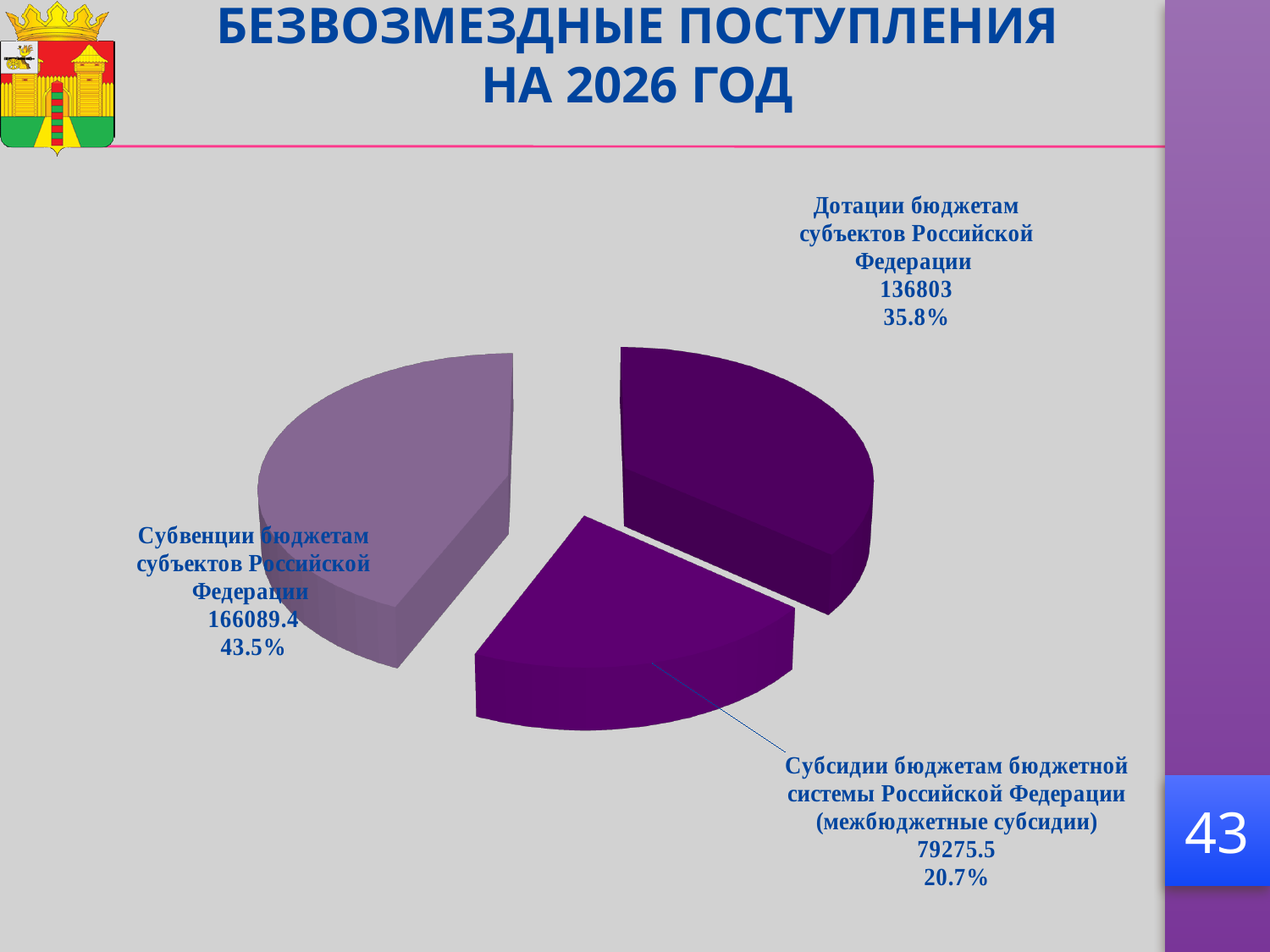
What is the value for Субвенции бюджетам субъектов Российской Федерации? 166089.4 What share of the pie does Субсидии бюджетам бюджетной системы Российской Федерации (межбюджетные субсидии) represent? 20.7% What is the value for Субсидии бюджетам бюджетной системы Российской Федерации (межбюджетные субсидии)? 79275.5 Which category has the smallest value? Субсидии бюджетам бюджетной системы Российской Федерации (межбюджетные субсидии) What share of the pie does Субвенции бюджетам субъектов Российской Федерации represent? 43.5% What is the difference between the values for Субвенции бюджетам субъектов Российской Федерации and Дотации бюджетам субъектов Российской Федерации? 29286.4 How many slices does the pie chart have? 3 Which is larger: the value for Дотации бюджетам субъектов Российской Федерации or the value for Субсидии бюджетам бюджетной системы Российской Федерации (межбюджетные субсидии)? Дотации бюджетам субъектов Российской Федерации What type of chart is shown on the slide? pie chart Which category has the largest value? Субвенции бюджетам субъектов Российской Федерации What is the title of the slide containing the pie chart? БЕЗВОЗМЕЗДНЫЕ ПОСТУПЛЕНИЯ НА 2026 ГОД What is the value for Дотации бюджетам субъектов Российской Федерации? 136803